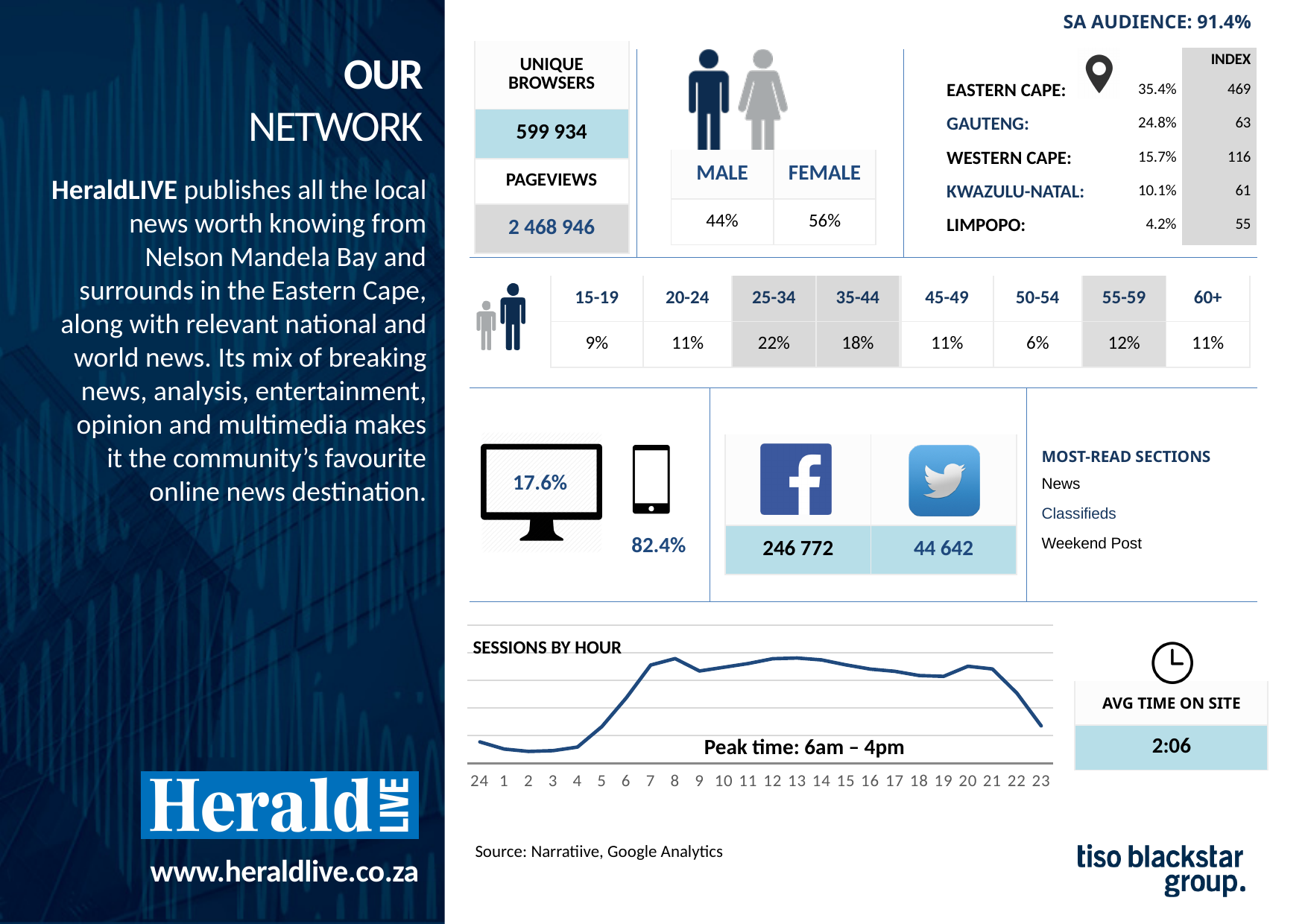
In the 'Sessions by hour' chart, which hour has more sessions, 20 or 23? 20 According to the annotation on the 'Sessions by hour' chart, what is the peak time? 6am – 4pm In the 'Sessions by hour' chart, do sessions rise or fall between hour 21 and hour 23? fall How many hour labels are shown on the x axis of the 'Sessions by hour' chart? 24 In the 'Sessions by hour' chart, do sessions rise or fall between hour 4 and hour 7? rise In the 'Sessions by hour' chart, which hour has more sessions, 13 or 2? 13 What kind of chart is the 'Sessions by hour' chart? line chart What is the title of the line chart at the bottom of the slide? SESSIONS BY HOUR In the 'Sessions by hour' chart, which hour has more sessions, 3 or 8? 8